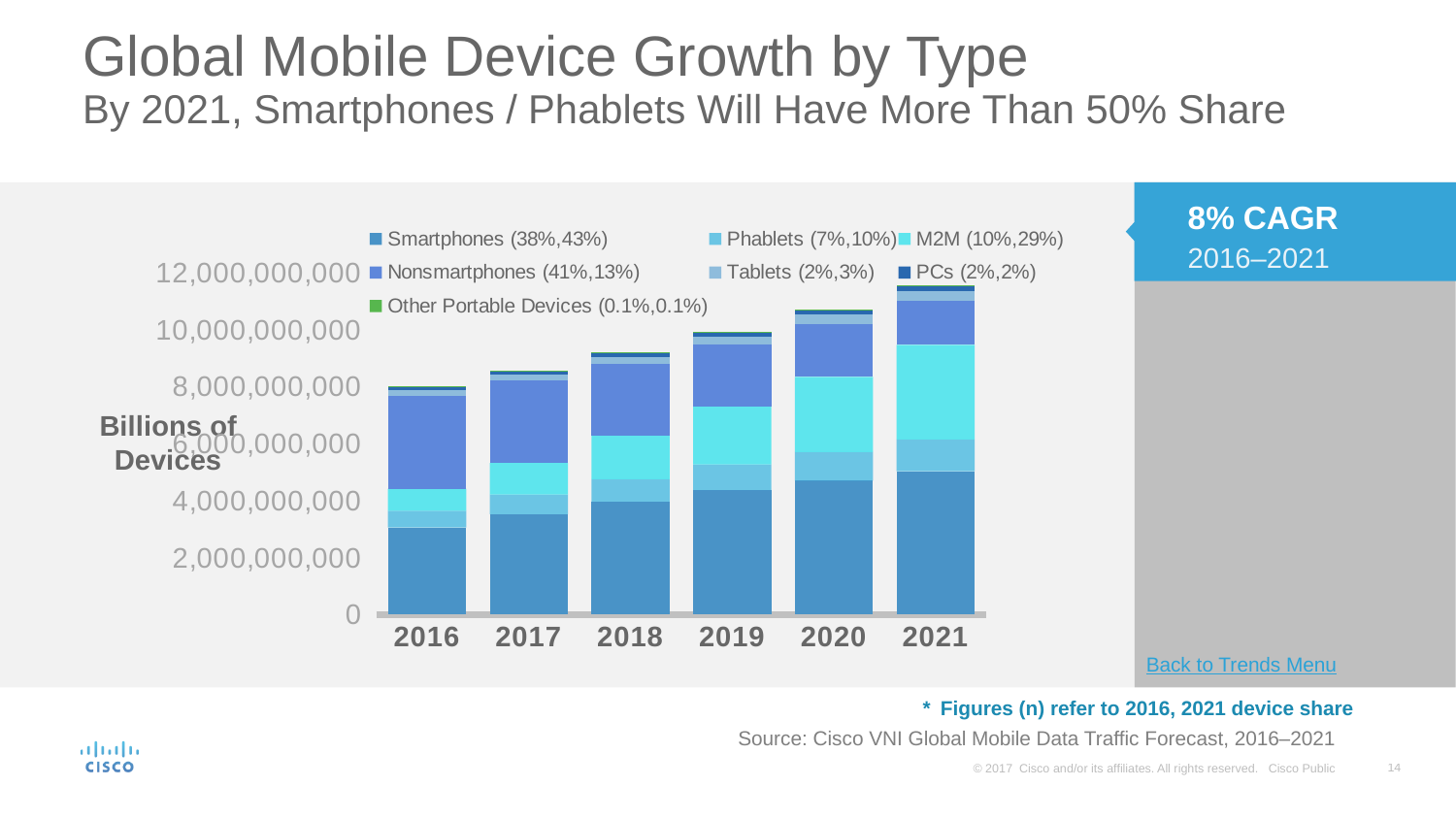
How many device types does the chart legend list? 7 Which year has the tallest stacked bar? 2021 Is the Smartphones segment for 2021 greater or less than 4,000,000,000? greater Is the total for 2018 greater or less than 10,000,000,000? less Is the Smartphones segment for 2016 greater or less than 4,000,000,000? less Which year has a larger total, 2016 or 2021? 2021 How many years are shown on the x axis of the chart? 6 Which year has the shortest stacked bar? 2016 What kind of chart is shown on the slide? Stacked bar chart What CAGR for 2016–2021 is stated next to the chart? 8% CAGR Do the total bar heights rise or fall from 2016 to 2021? Rise